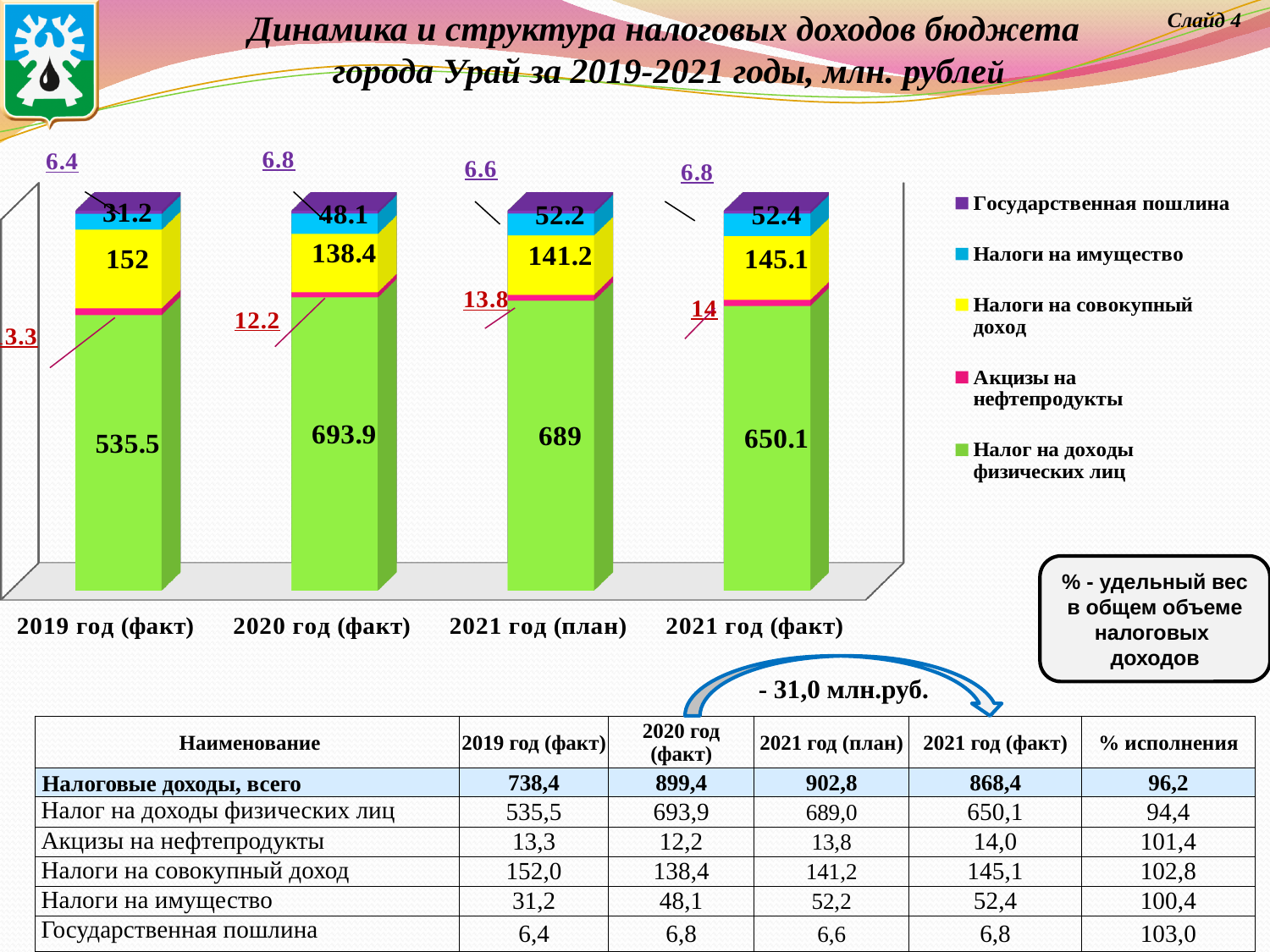
What is the value of Налоги на имущество for 2021 год (факт)? 52.4 Which series is shown in green in the chart? Налог на доходы физических лиц How many bars (categories) are plotted in the chart? 4 What is the difference between Налог на доходы физических лиц for 2021 год (план) and 2021 год (факт)? 38.9 Which is larger: Налоги на совокупный доход for 2020 год (факт) or for 2021 год (факт)? 2021 год (факт) What is the value of Налог на доходы физических лиц for 2020 год (факт)? 693.9 Which category has the lowest value for Налоги на имущество? 2019 год (факт) What is the value of Государственная пошлина for 2021 год (план)? 6.6 How many series does the chart legend list? 5 Which category has the highest value for Налог на доходы физических лиц? 2020 год (факт) What is the value of Налоги на совокупный доход for 2019 год (факт)? 152 What kind of chart is shown on the slide? stacked bar chart